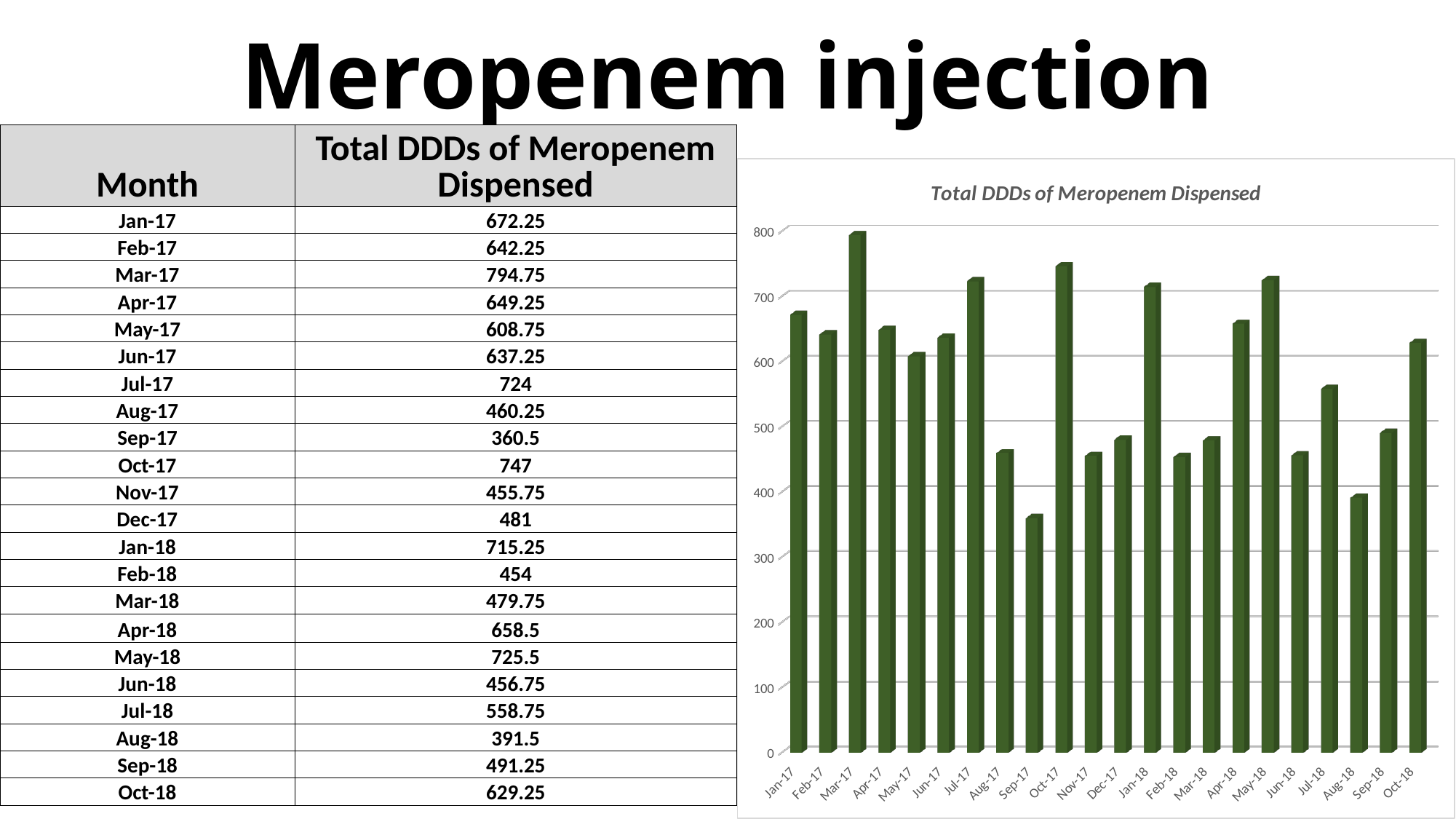
What type of chart is shown on the slide? bar chart Is the value for Aug-18 greater or less than 400? less What is the title of the chart? Total DDDs of Meropenem Dispensed Is the value for Jul-18 greater or less than 500? greater Which month has a larger value, Oct-17 or Jan-18? Oct-17 How many months are plotted in the chart? 22 What is the total DDDs of Meropenem dispensed in Oct-18? 629.25 Which month has the highest total DDDs of Meropenem dispensed? Mar-17 What is the total DDDs of Meropenem dispensed in Mar-17? 794.75 What is the difference between the total DDDs dispensed in Mar-17 and Sep-17? 434.25 Which month has the lowest total DDDs of Meropenem dispensed? Sep-17 What is the total DDDs of Meropenem dispensed in Sep-17? 360.5